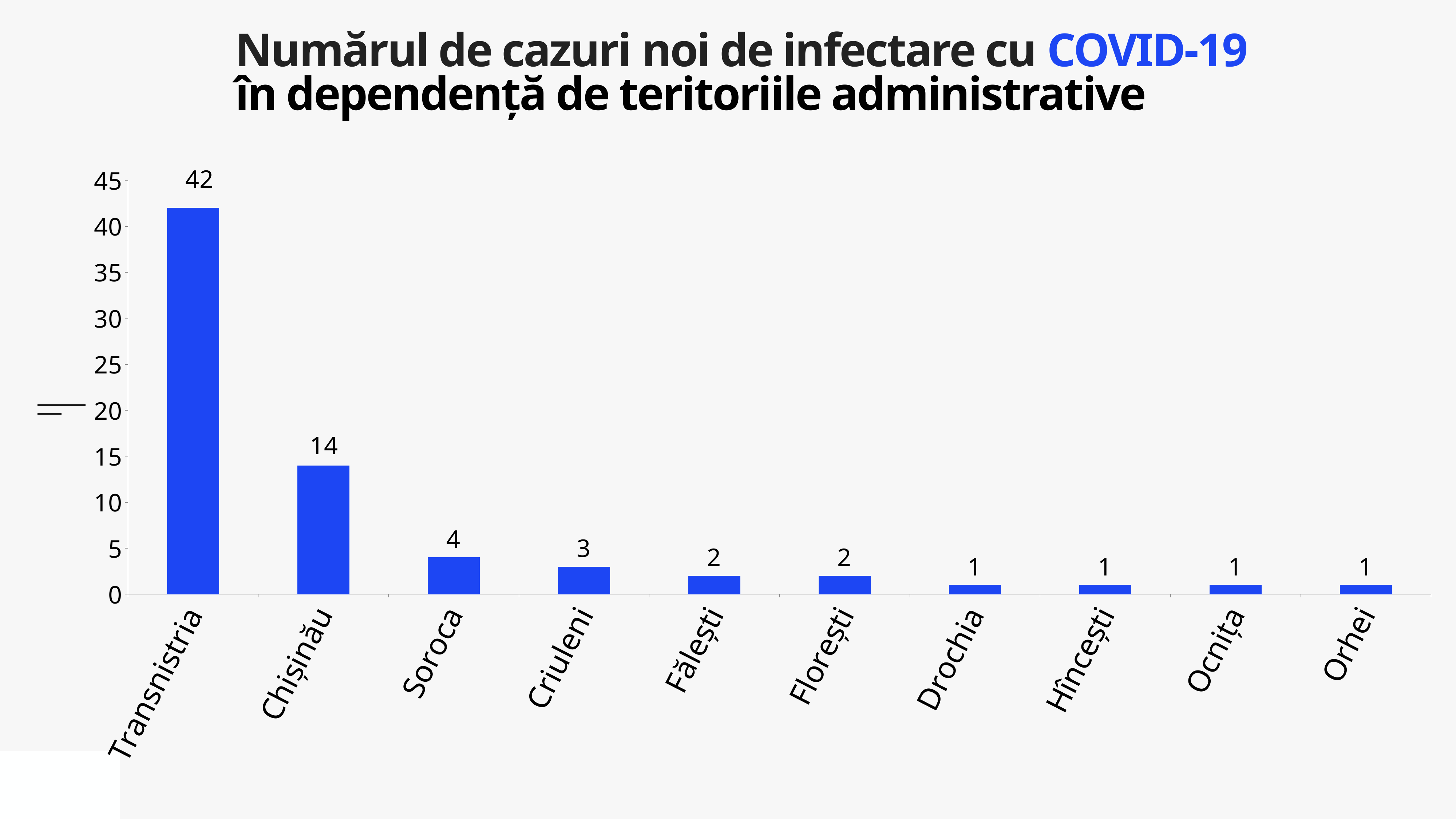
What is the value for Criuleni? 3 What is the value for Transnistria? 42 What kind of chart is shown on the slide? bar chart What is the difference between the values for Transnistria and Chișinău? 28 Which category has the highest value? Transnistria Do the values rise or fall from left to right along the x axis? fall Is the value for Transnistria greater or less than 40? greater How many categories are shown on the x axis? 10 What is the value for Chișinău? 14 What is the value for Soroca? 4 What colour are the bars in the chart? blue Which is larger, the value for Soroca or the value for Criuleni? Soroca